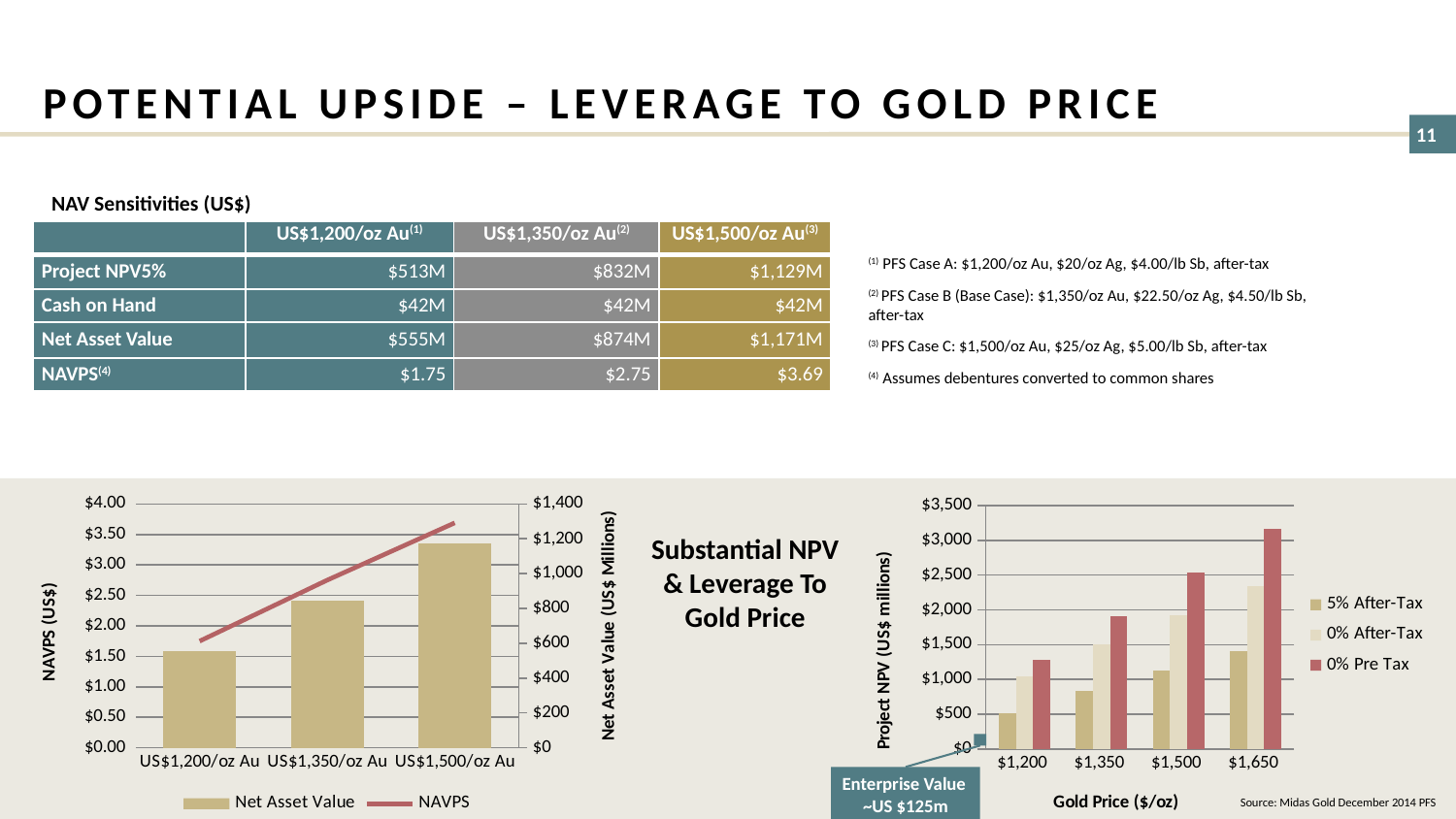
In the left chart (NAVPS and Net Asset Value), which is larger: the Net Asset Value at US$1,200/oz Au or at US$1,500/oz Au? US$1,500/oz Au In the right chart (Project NPV vs Gold Price), is the 0% Pre Tax value at $1,650 greater or less than $3,000? greater In the right chart (Project NPV vs Gold Price), what are the three series named in the legend? 5% After-Tax, 0% After-Tax, 0% Pre Tax In the left chart (NAVPS and Net Asset Value), is the Net Asset Value bar for US$1,500/oz Au greater or less than $1,000 million? greater What kind of chart is the right chart (Project NPV vs Gold Price)? Bar chart In the right chart (Project NPV vs Gold Price), how many series does the legend list? 3 In the right chart (Project NPV vs Gold Price), which series has the tallest bar at the $1,650 gold price? 0% Pre Tax In the left chart (NAVPS and Net Asset Value), how many gold price categories are shown on the x axis? 3 In the left chart (NAVPS and Net Asset Value), how many series does the legend list? 2 In the right chart (Project NPV vs Gold Price), is the 5% After-Tax value at $1,650 greater or less than $1,500? less In the right chart (Project NPV vs Gold Price), do the 0% Pre Tax values rise or fall as the gold price increases? Rise In the right chart (Project NPV vs Gold Price), how many gold price categories are shown on the x axis? 4